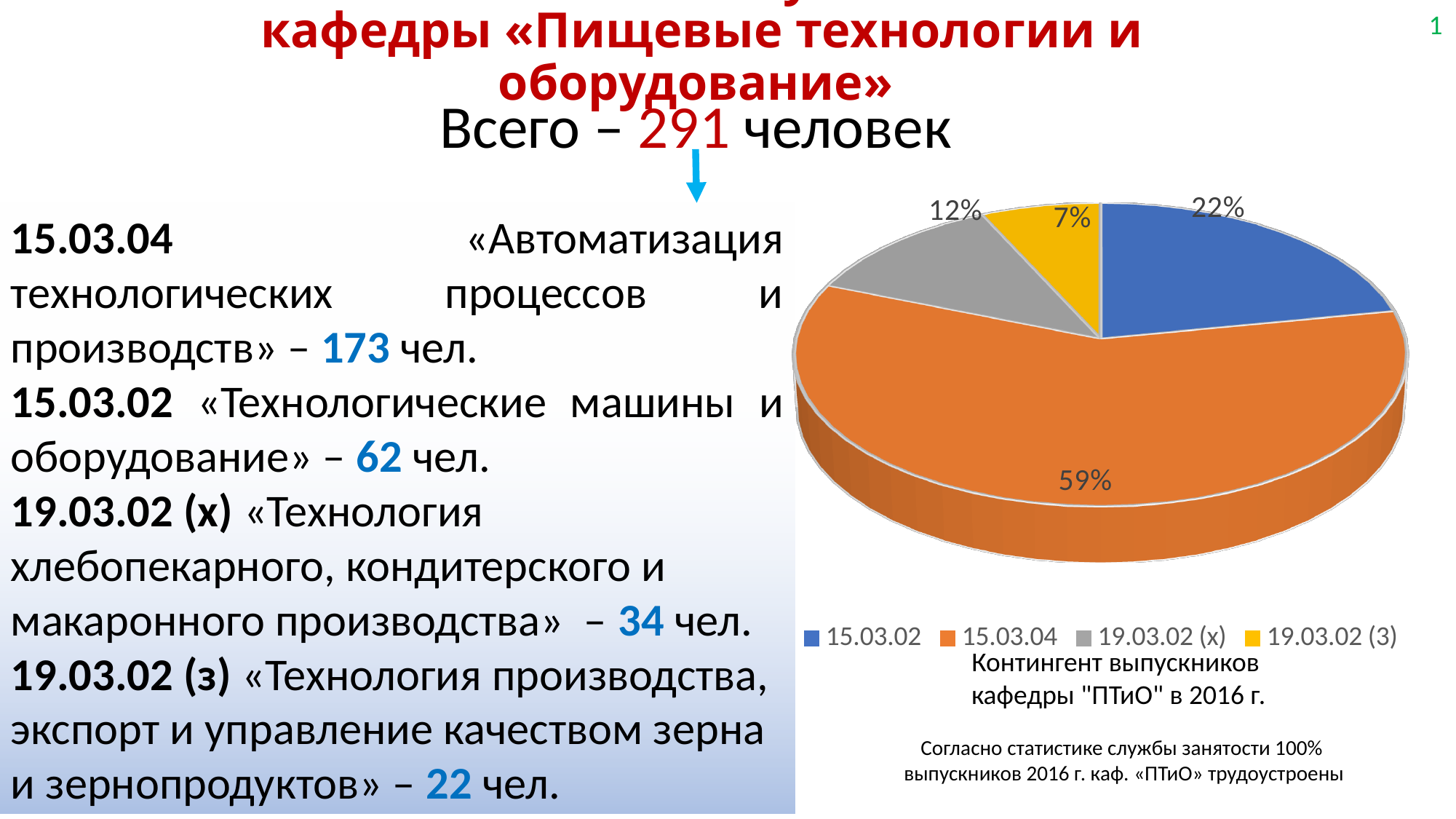
What share of the pie does 19.03.02 (х) have? 12% Which category has the smallest slice of the pie? 19.03.02 (з) Which slice is larger, 19.03.02 (х) or 19.03.02 (з)? 19.03.02 (х) Which category has the largest slice of the pie? 15.03.04 What share of the pie does 19.03.02 (з) have? 7% What colour is the slice for 19.03.02 (з)? yellow How many categories does the pie chart show? 4 What kind of chart is shown on the slide? pie chart What is the title of the pie chart? Контингент выпускников кафедры "ПТиО" в 2016 г. What is the difference in percentage points between the 15.03.04 slice and the 15.03.02 slice? 37 What share of the pie does 15.03.02 have? 22%